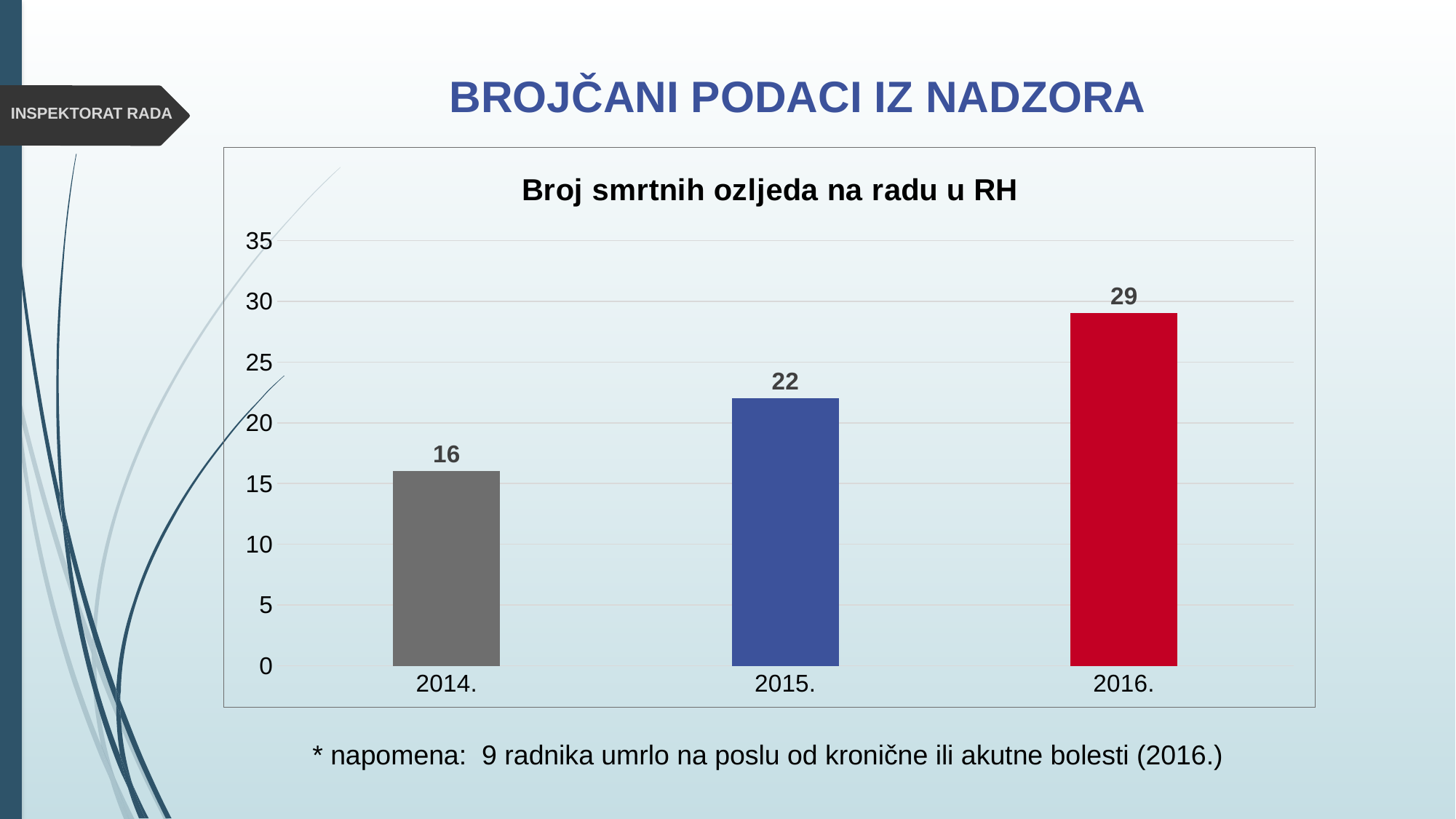
Is the value for 2016. greater or less than 25? greater What is the value for 2014. in the chart? 16 Which year has the lowest number of fatal injuries at work? 2014. What is the value for 2015. in the chart? 22 What is the difference between the values for 2016. and 2014.? 13 What is the difference between the values for 2015. and 2014.? 6 How many years are shown on the x axis of the chart? 3 What kind of chart is shown on the slide? bar chart Which year has the highest number of fatal injuries at work? 2016. Do the values rise or fall from 2014. to 2016.? rise Which is larger, the value for 2015. or the value for 2016.? 2016. What is the value for 2016. in the chart? 29